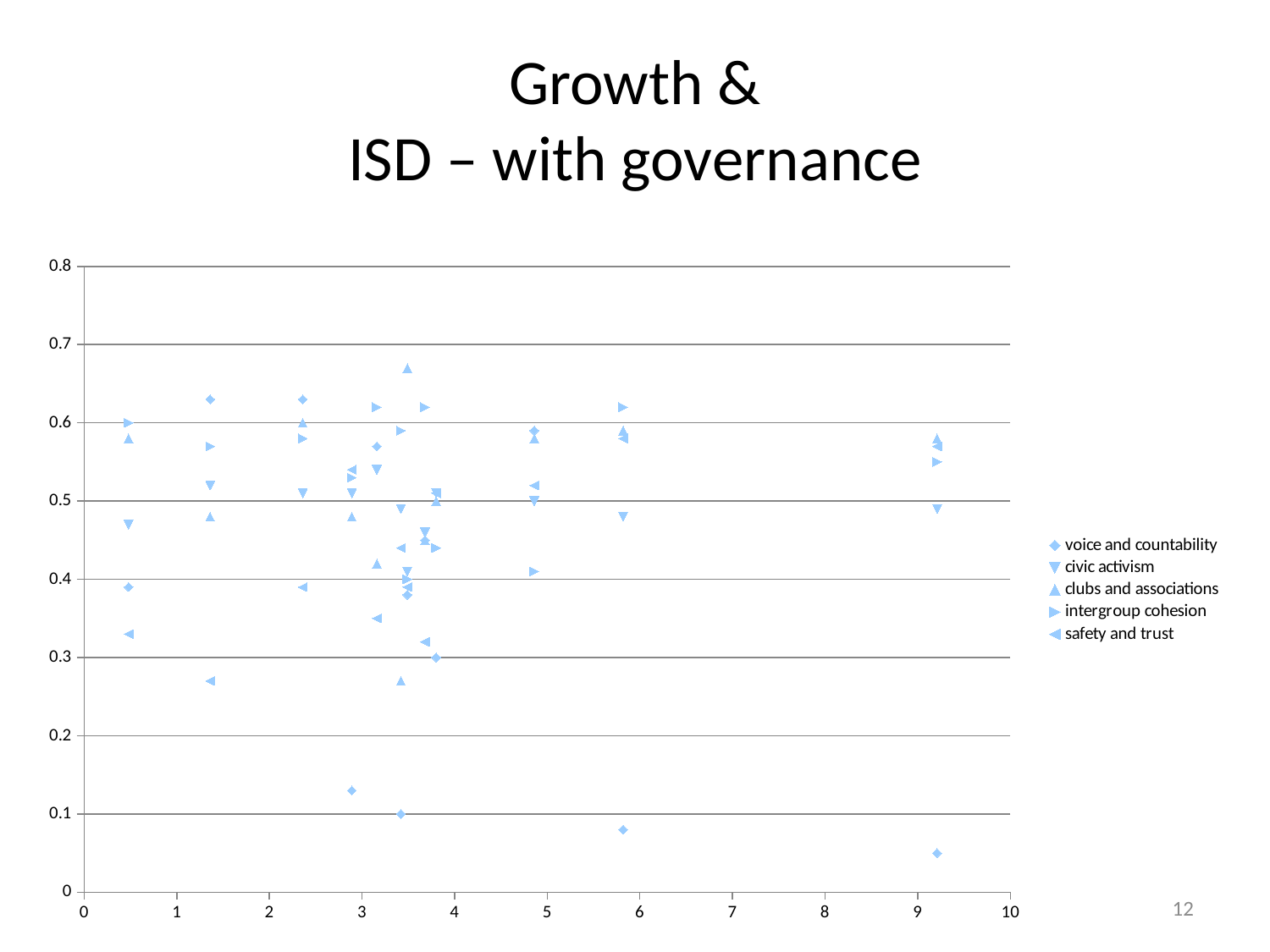
What is the maximum value shown on the vertical axis? 0.8 Is the lowest point on the chart, near x = 9, greater or less than 0.1? less Which series is listed last in the legend? safety and trust Which series has the highest point on the chart? clubs and associations What kind of chart is shown on the slide? scatter chart How many series does the legend list? 5 What is the title of the chart on the slide? Growth & ISD – with governance Which series has the lowest point on the chart? voice and countability Is the voice and countability point near x = 3 at the bottom of the chart greater or less than 0.1? greater Is the highest point on the chart greater or less than 0.7? less